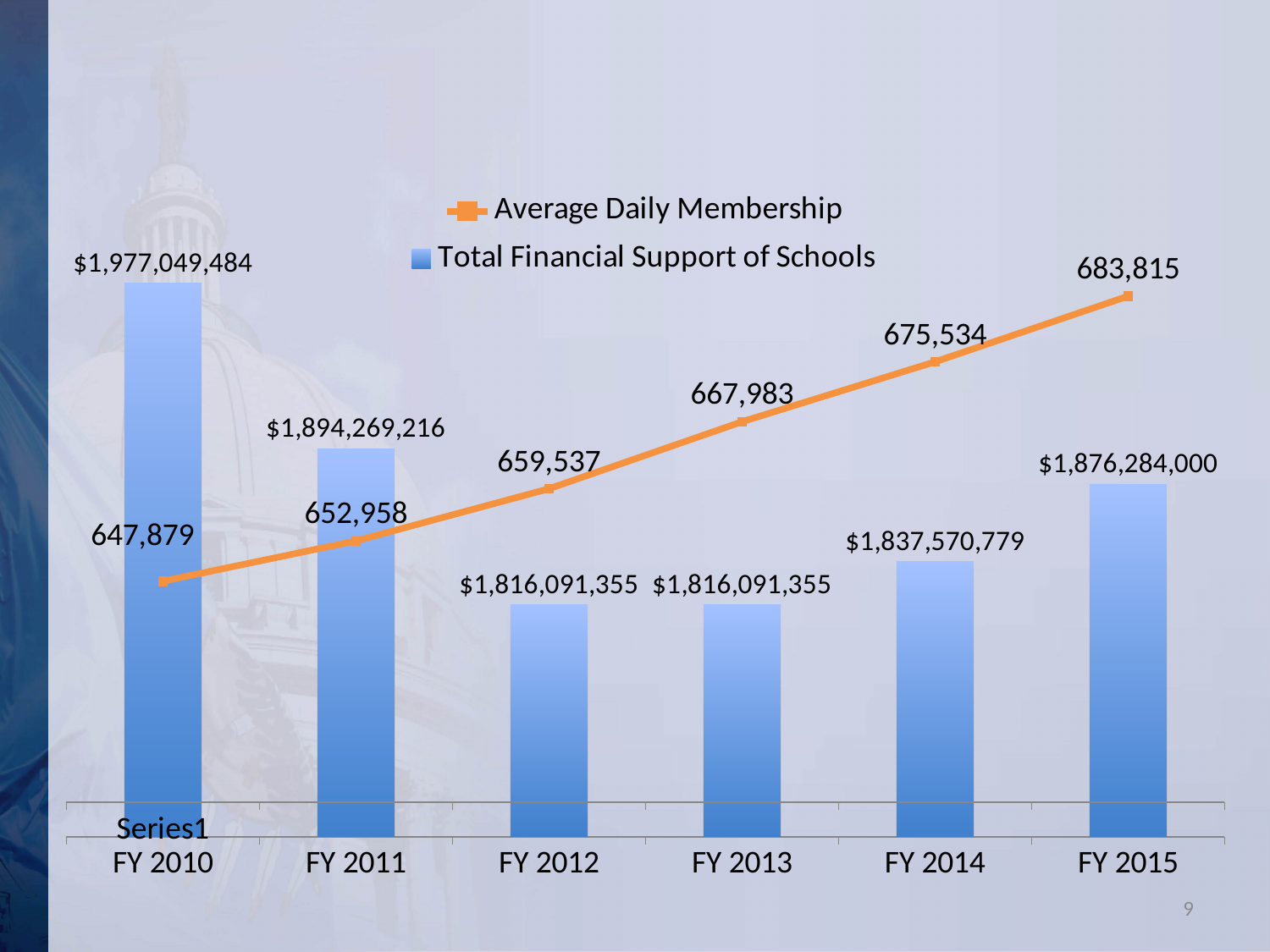
What is the Average Daily Membership for FY 2013? 667,983 By how much did Average Daily Membership increase from FY 2010 to FY 2015? 35,936 Which fiscal year has the lowest Average Daily Membership? FY 2010 Which is larger, the Total Financial Support of Schools in FY 2011 or in FY 2014? FY 2011 What is the difference in Total Financial Support of Schools between FY 2010 and FY 2015? $100,765,484 Which series is shown as an orange line? Average Daily Membership What is the Total Financial Support of Schools for FY 2010? $1,977,049,484 How many series does the legend list? 2 What is the Total Financial Support of Schools for FY 2015? $1,876,284,000 Does Average Daily Membership rise or fall from FY 2010 to FY 2015? rise Which fiscal year has the highest Total Financial Support of Schools? FY 2010 How many fiscal years are shown on the x axis? 6